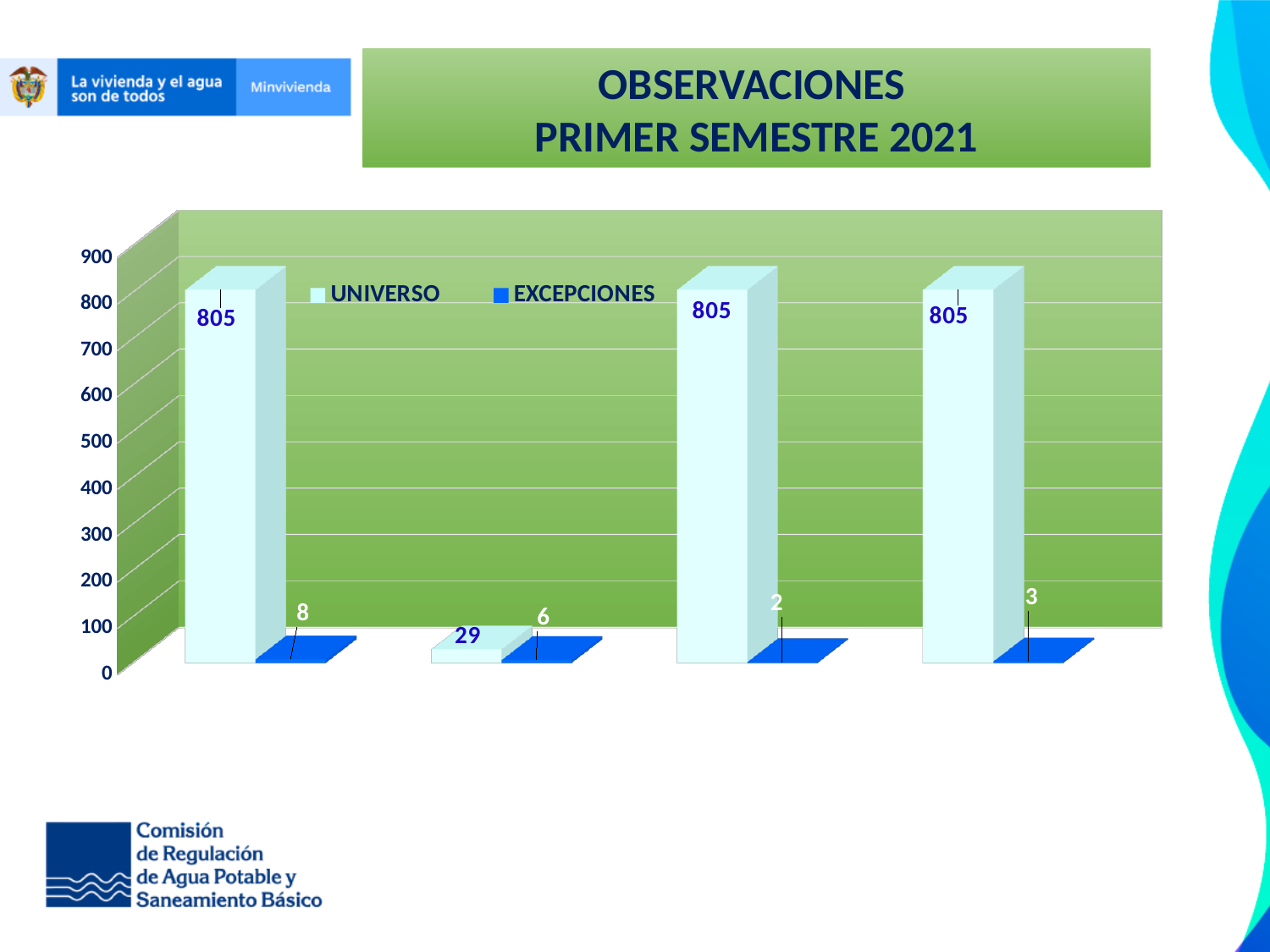
What kind of chart is shown on the slide? bar chart How many series does the chart legend list? 2 Is the EXCEPCIONES value larger in the first group or in the second group of bars from the left? the first group In the second group of bars from the left, what is the difference between the UNIVERSO value and the EXCEPCIONES value? 23 How many groups of bars are plotted in the chart? 4 What is the EXCEPCIONES value for the third group of bars from the left? 2 What is the EXCEPCIONES value for the first group of bars from the left? 8 Which group of bars has the lowest UNIVERSO value? the second group from the left What are the two series named in the chart legend? UNIVERSO and EXCEPCIONES Which group of bars has the highest EXCEPCIONES value? the first group from the left What is the UNIVERSO value for the fourth group of bars from the left? 805 What is the UNIVERSO value for the second group of bars from the left? 29